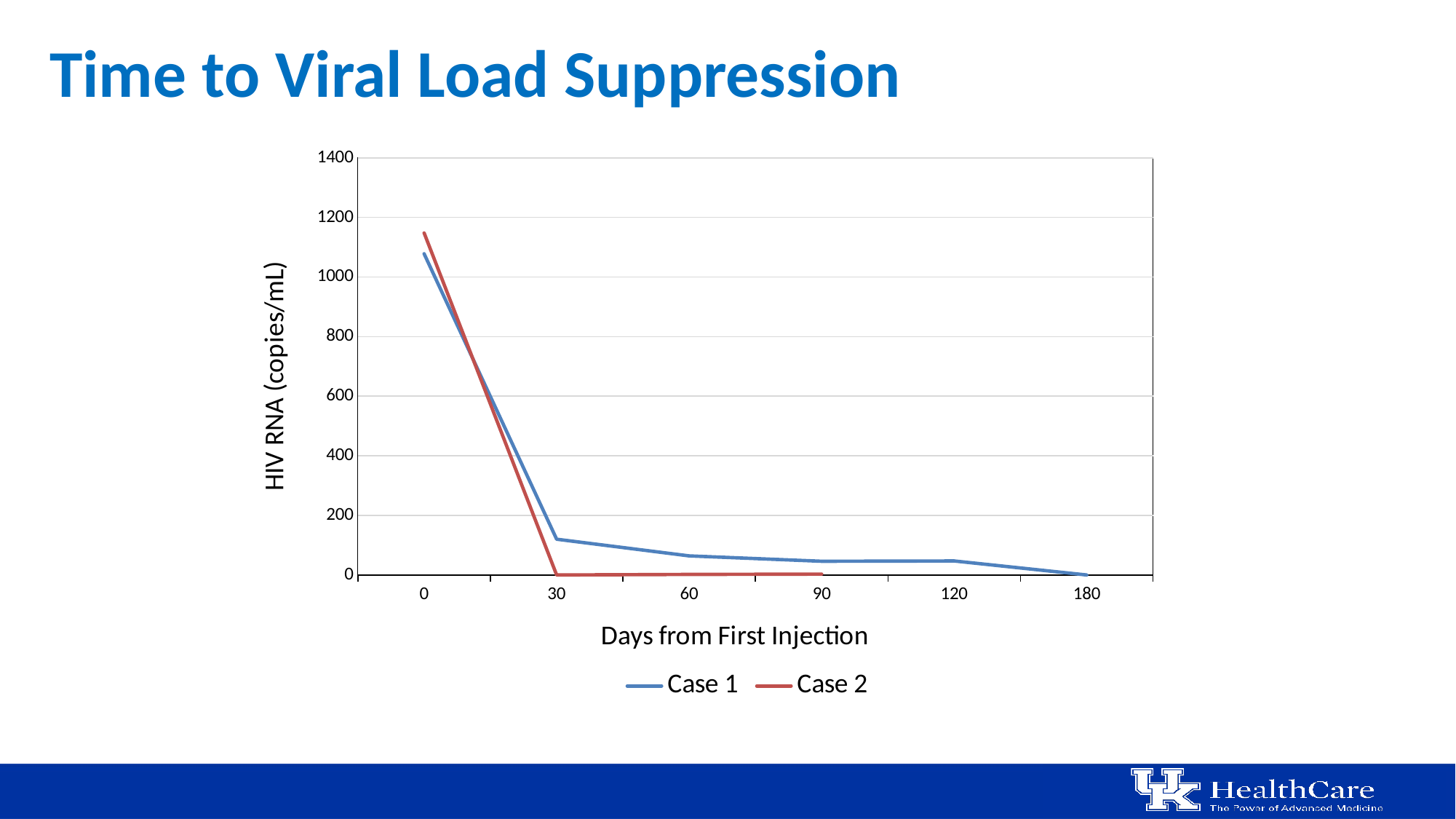
At day 30, which series has the higher value, Case 1 or Case 2? Case 1 What is the title of the chart? Time to Viral Load Suppression What is the value for Case 2 at day 30? 0 What is the value for Case 1 at day 180? 0 How many series does the legend list? 2 What is the label of the y axis? HIV RNA (copies/mL) Does the value for Case 1 rise or fall from day 0 to day 180? fall Is the value for Case 1 at day 30 greater or less than 200? less Is the value for Case 1 at day 0 greater or less than 1000? greater What kind of chart is shown on the slide? line chart Is the value for Case 2 at day 0 greater or less than 1000? greater How many labelled tick values are shown on the x axis? 6